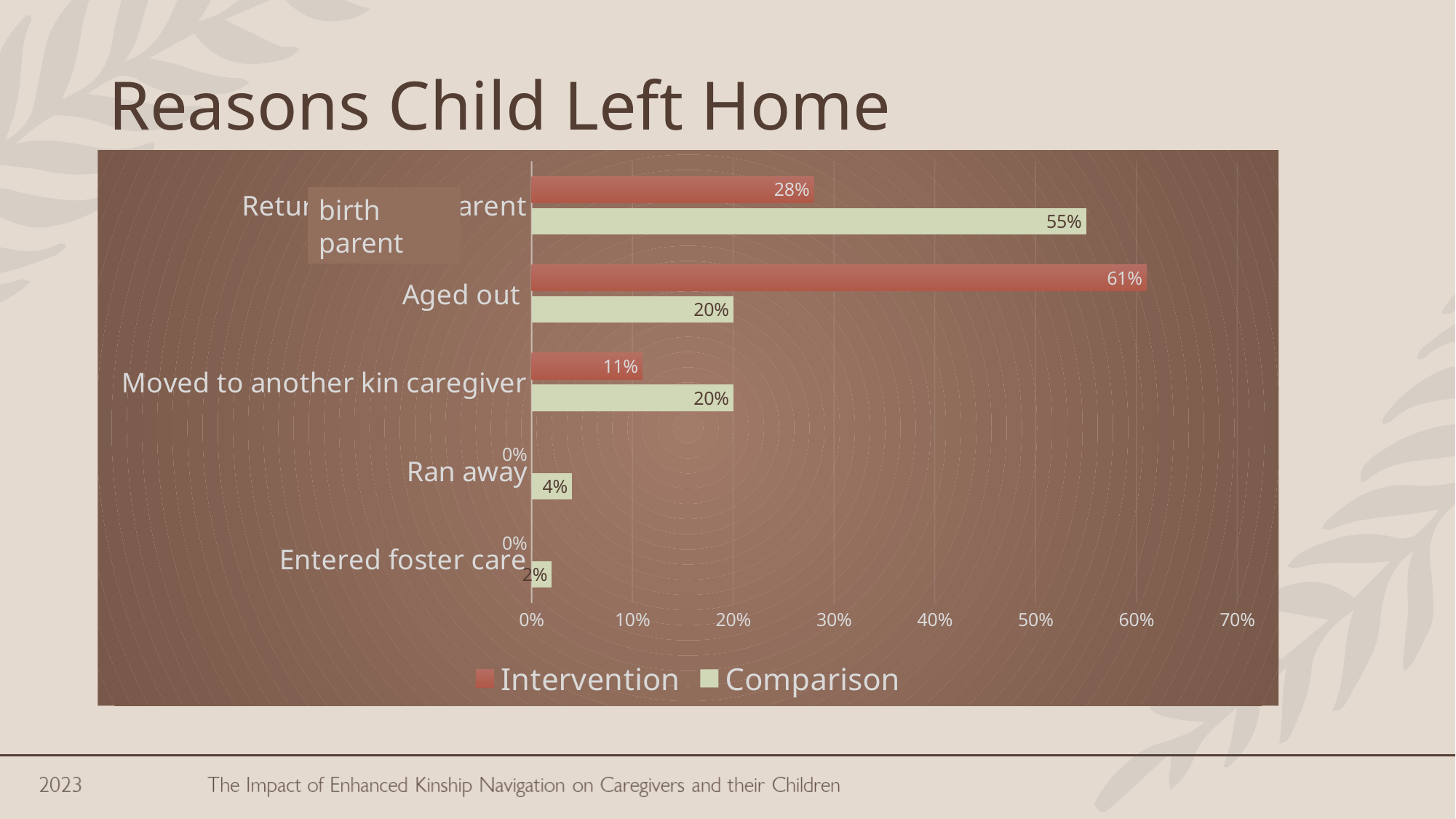
How many categories are shown on the chart? 5 What is the Intervention value for Moved to another kin caregiver? 11% For Moved to another kin caregiver, which series has the larger value, Intervention or Comparison? Comparison What is the Comparison value for Ran away? 4% What is the Intervention value for Ran away? 0% What is the difference between the Intervention and Comparison values for Aged out? 41% What type of chart is shown on the slide? bar chart What is the Comparison value for Entered foster care? 2% What is the Intervention value for Aged out? 61% What is the Comparison value for Aged out? 20% Which category has the highest Intervention value? Aged out How many series does the legend list? 2